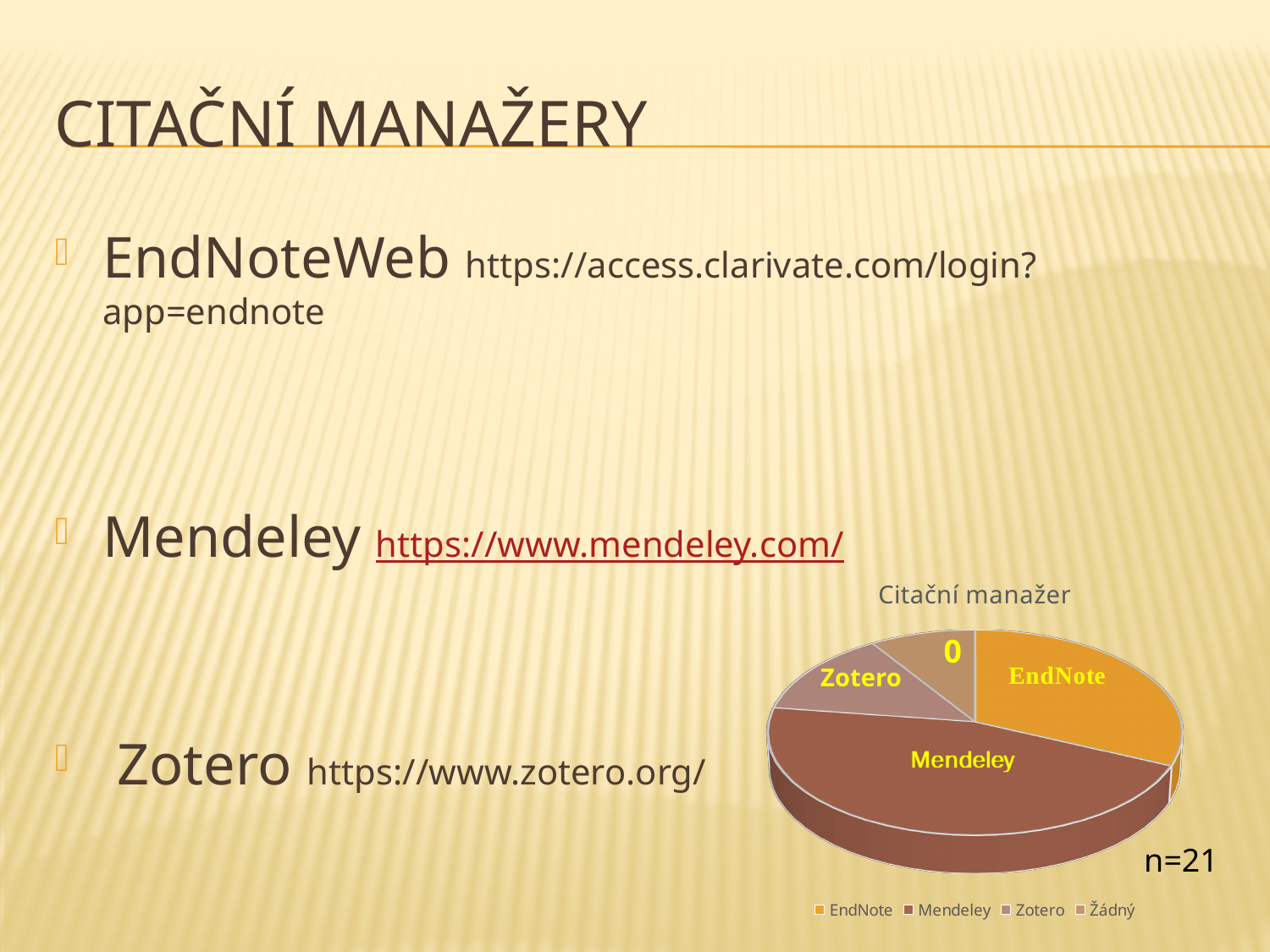
Which category has the largest slice in the pie chart? Mendeley What is the title of the chart on the slide? Citační manažer Which slice is larger, EndNote or Zotero? EndNote What sample size (n) is shown next to the chart? n=21 Which slice is larger, Mendeley or EndNote? Mendeley Which slice is larger, Zotero or Mendeley? Mendeley What kind of chart is shown on the slide? pie chart How many slices does the pie chart have? 4 How many entries does the chart legend list? 4